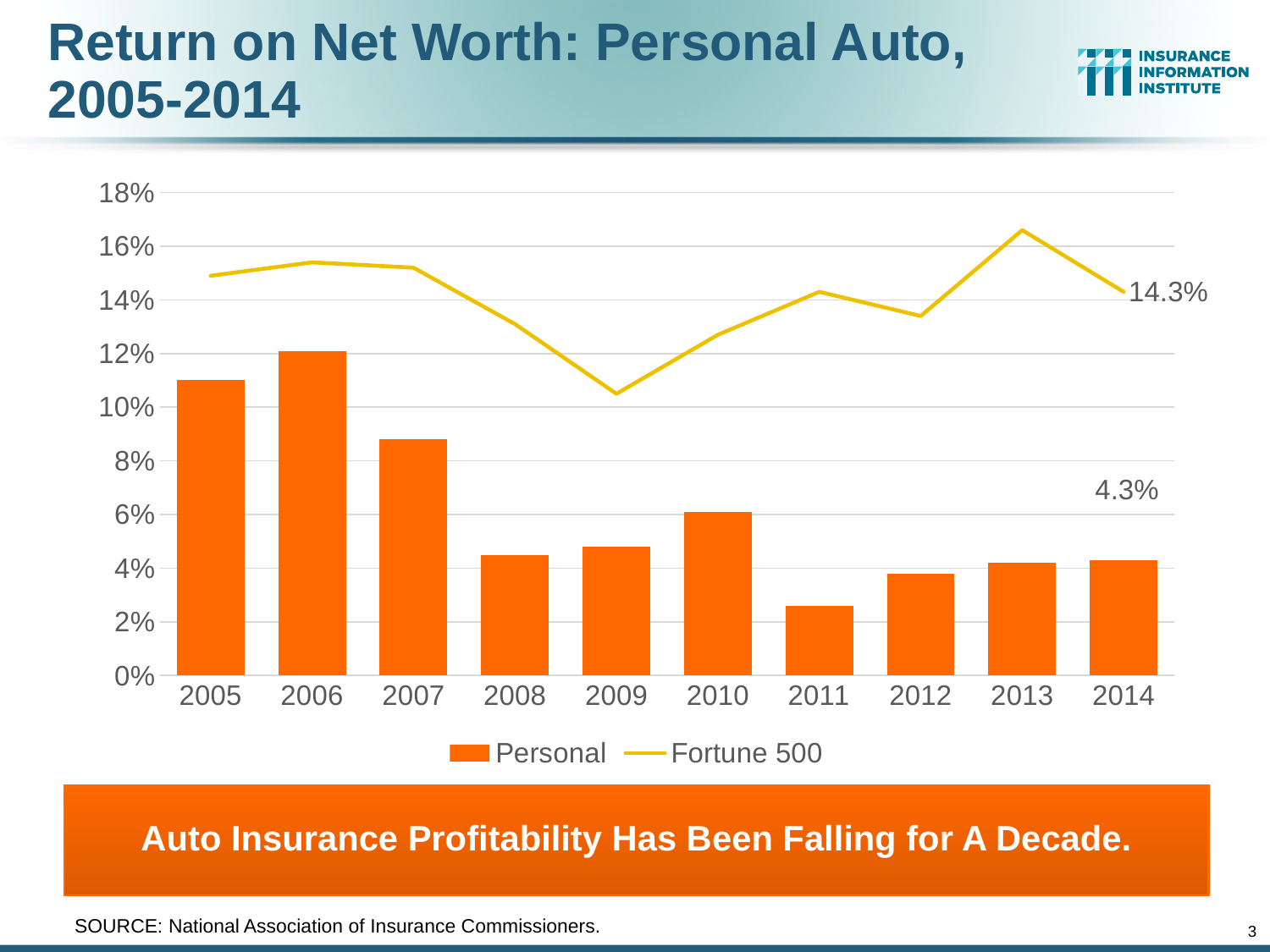
In which year is the Personal return on net worth highest? 2006 What is the Fortune 500 return on net worth for 2014? 14.3% Which is larger in 2014, the Personal value or the Fortune 500 value? Fortune 500 What is the difference between the Fortune 500 and Personal values in 2014? 10 percentage points Is the Personal value for 2005 greater or less than 10%? greater How many years are shown on the x axis? 10 In which year is the Personal return on net worth lowest? 2011 What is the Personal return on net worth for 2014? 4.3% In which year does the Fortune 500 line reach its highest point? 2013 Is the Fortune 500 value for 2009 greater or less than 12%? less In which year does the Fortune 500 line reach its lowest point? 2009 How many series does the legend list? 2